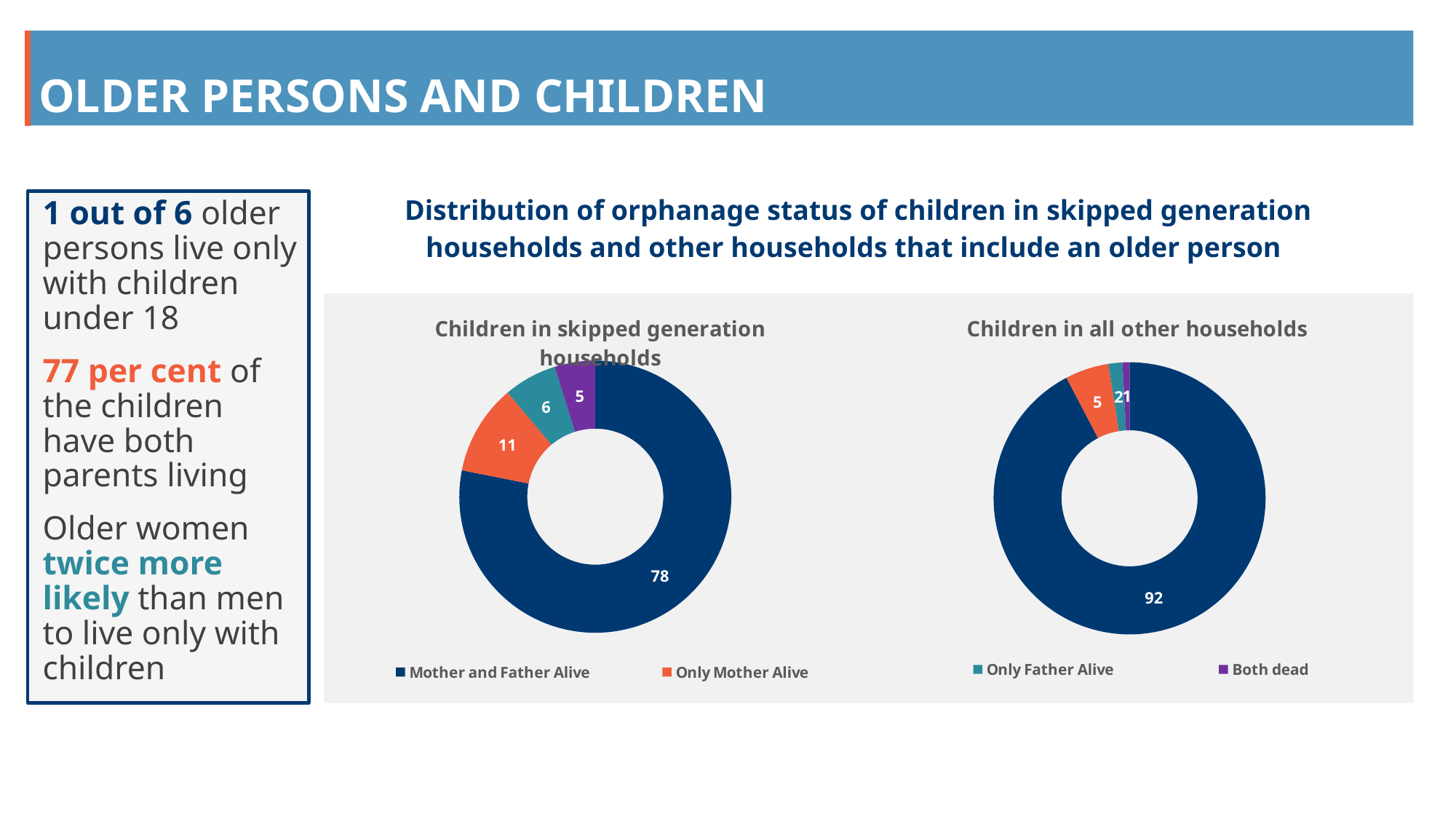
In the 'Children in skipped generation households' chart, which category has the largest slice? Mother and Father Alive How many categories does the legend list for the charts? 4 In the 'Children in all other households' chart, what is the value for Only Mother Alive? 5 What is the difference between the Mother and Father Alive values in the 'Children in all other households' chart and the 'Children in skipped generation households' chart? 14 In the 'Children in skipped generation households' chart, what is the value for Mother and Father Alive? 78 In the 'Children in skipped generation households' chart, what is the value for Both dead? 5 In the 'Children in skipped generation households' chart, which is larger: Only Mother Alive or Only Father Alive? Only Mother Alive In the 'Children in skipped generation households' chart, which category has the smallest slice? Both dead What kind of chart is used for 'Children in all other households'? doughnut chart In the 'Children in skipped generation households' chart, what is the value for Only Father Alive? 6 In the 'Children in skipped generation households' chart, what is the value for Only Mother Alive? 11 In the 'Children in all other households' chart, what is the value for Mother and Father Alive? 92